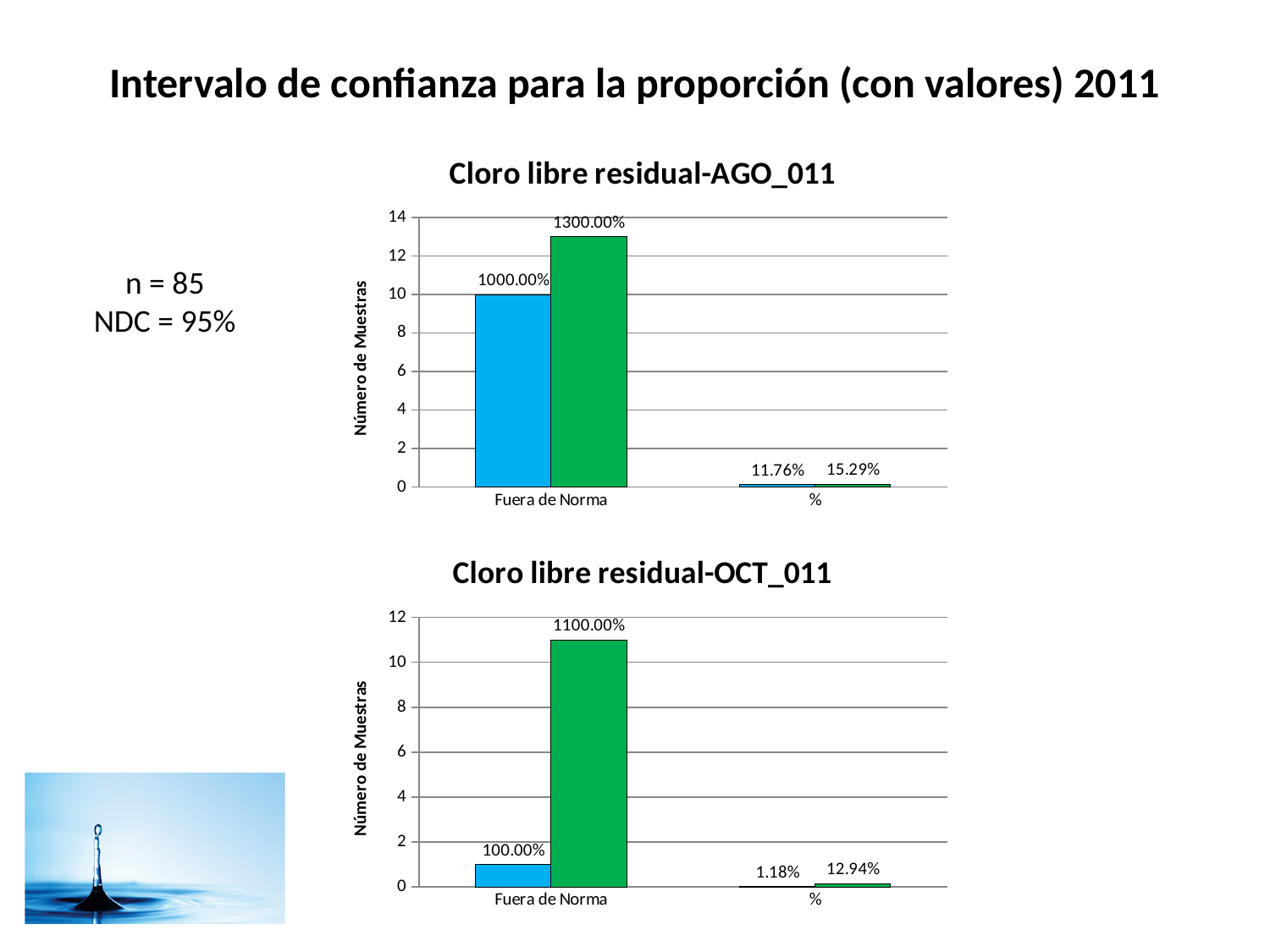
What is the y-axis title of the 'Cloro libre residual-OCT_011' chart? Número de Muestras How many categories are shown on the x axis of the 'Cloro libre residual-OCT_011' chart? 2 In the 'Cloro libre residual-OCT_011' chart, what is the data label on the blue bar for the '%' category? 1.18% In the 'Cloro libre residual-OCT_011' chart, what is the data label on the green bar for 'Fuera de Norma'? 1100.00% What type of chart is 'Cloro libre residual-AGO_011'? Bar chart In the 'Cloro libre residual-AGO_011' chart, is the blue bar for 'Fuera de Norma' greater or less than 8 on the y axis? greater In the 'Cloro libre residual-OCT_011' chart, for 'Fuera de Norma', which bar is taller, the blue one or the green one? The green one In the 'Cloro libre residual-AGO_011' chart, which bar is the tallest? The green bar for Fuera de Norma In the 'Cloro libre residual-OCT_011' chart, what is the data label on the green bar for the '%' category? 12.94% In the 'Cloro libre residual-AGO_011' chart, what is the data label on the green bar for 'Fuera de Norma'? 1300.00% In the 'Cloro libre residual-AGO_011' chart, what is the data label on the blue bar for the '%' category? 11.76% What is the title of the top chart on the slide? Cloro libre residual-AGO_011